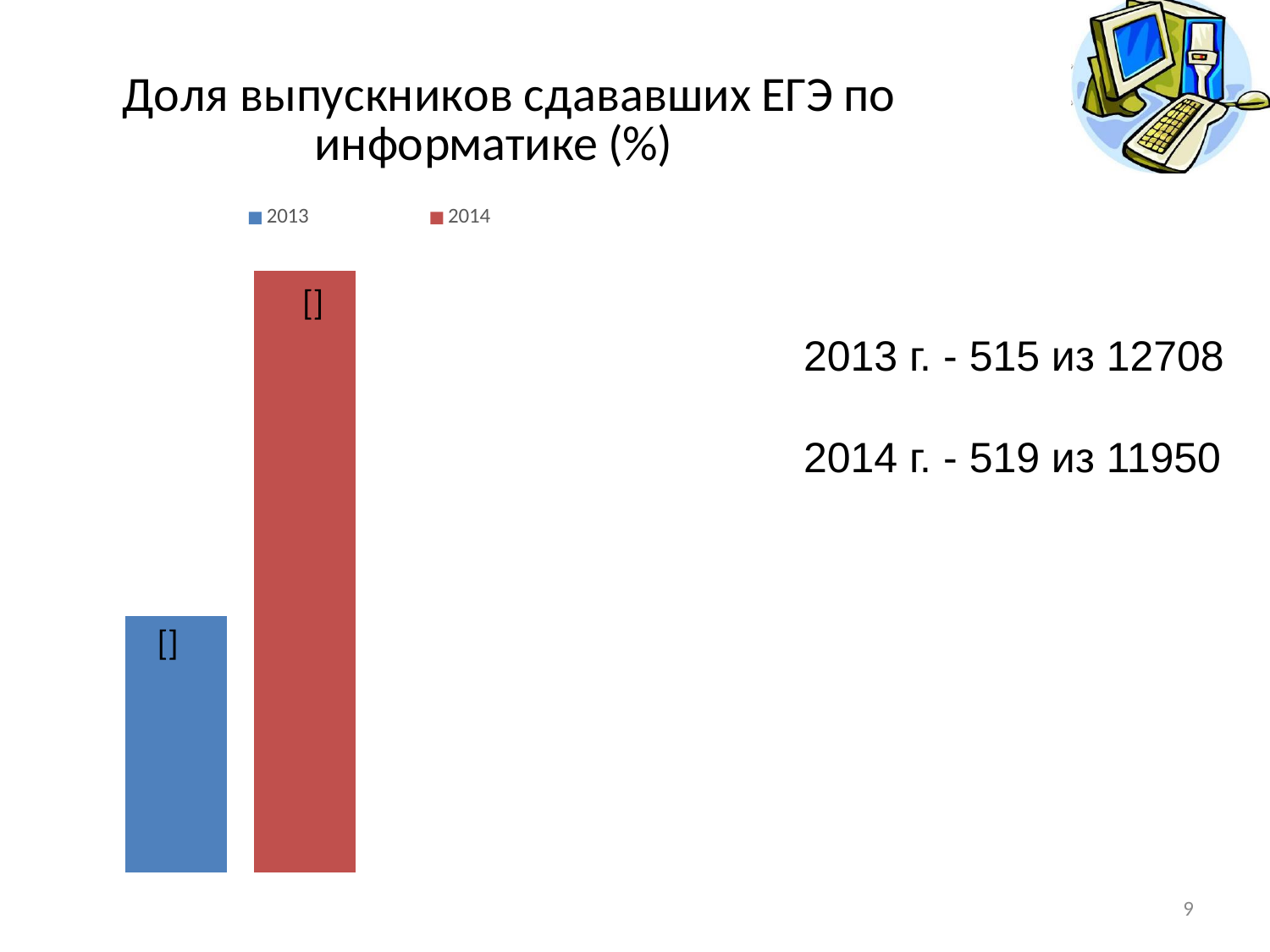
What kind of chart is shown on the slide? bar chart Which colour represents the 2014 series in the legend? red What is the title of the chart? Доля выпускников сдававших ЕГЭ по информатике (%) Does the value rise or fall from 2013 to 2014? rise Which year has the taller bar, 2013 or 2014? 2014 Which series has the lowest value in the chart? 2013 How many series does the legend list? 2 Which series has the highest value in the chart? 2014 How many bars are plotted in the chart? 2